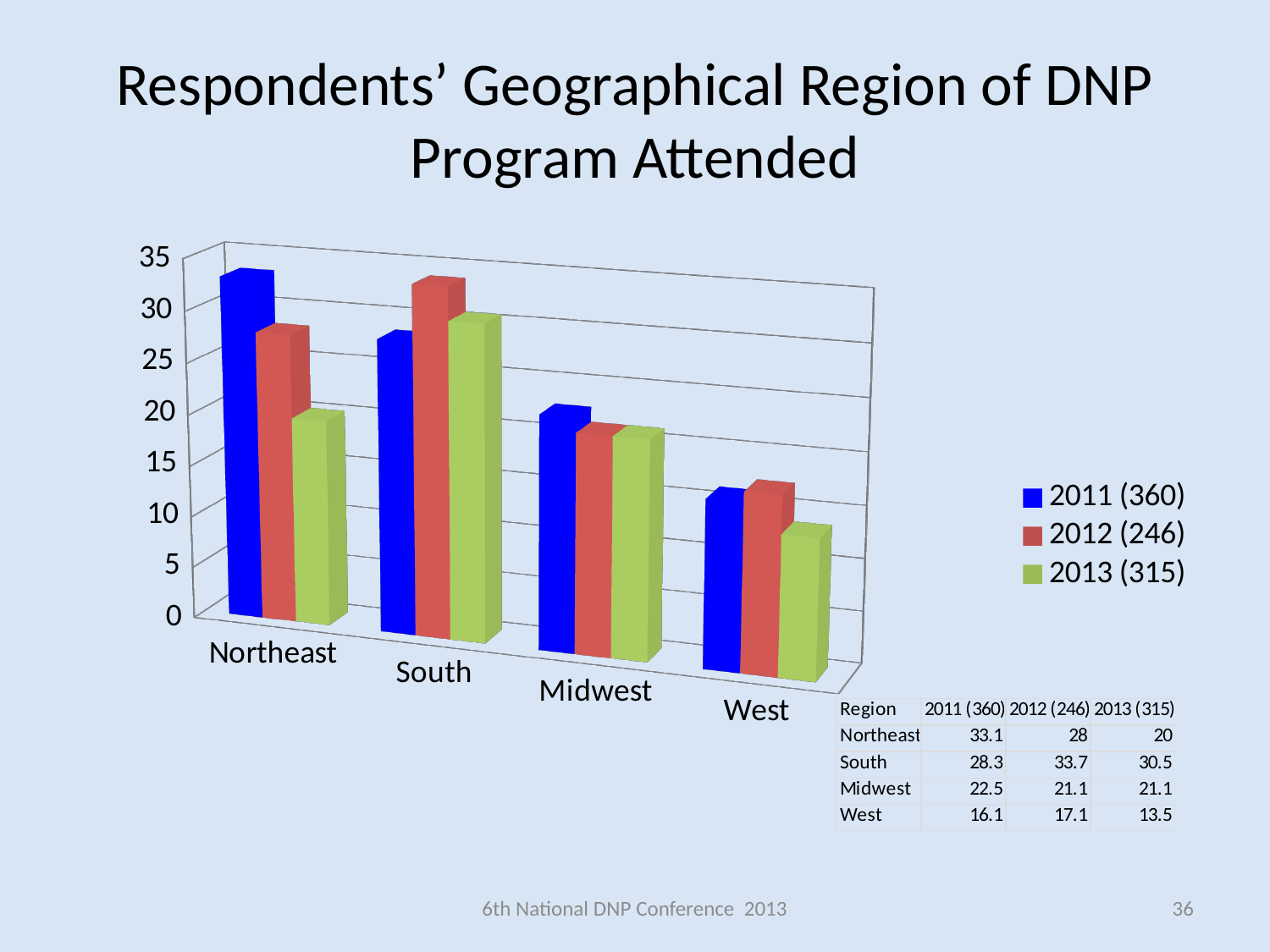
What is the difference between the 2011 (360) and 2013 (315) values for Northeast? 13.1 Which is larger for South: the 2011 (360) value or the 2012 (246) value? 2012 (246) How many regions are shown on the x axis of the chart? 4 What is the value for South in the 2012 (246) series? 33.7 What kind of chart is shown on the slide? Bar chart How many series does the chart legend list? 3 Is the value for Midwest in the 2011 (360) series greater or less than 20? greater Which colour represents the 2013 (315) series in the chart? Green Which region has the lowest value in the 2013 (315) series? West What is the value for Northeast in the 2011 (360) series? 33.1 What is the value for West in the 2013 (315) series? 13.5 Which region has the highest value in the 2011 (360) series? Northeast